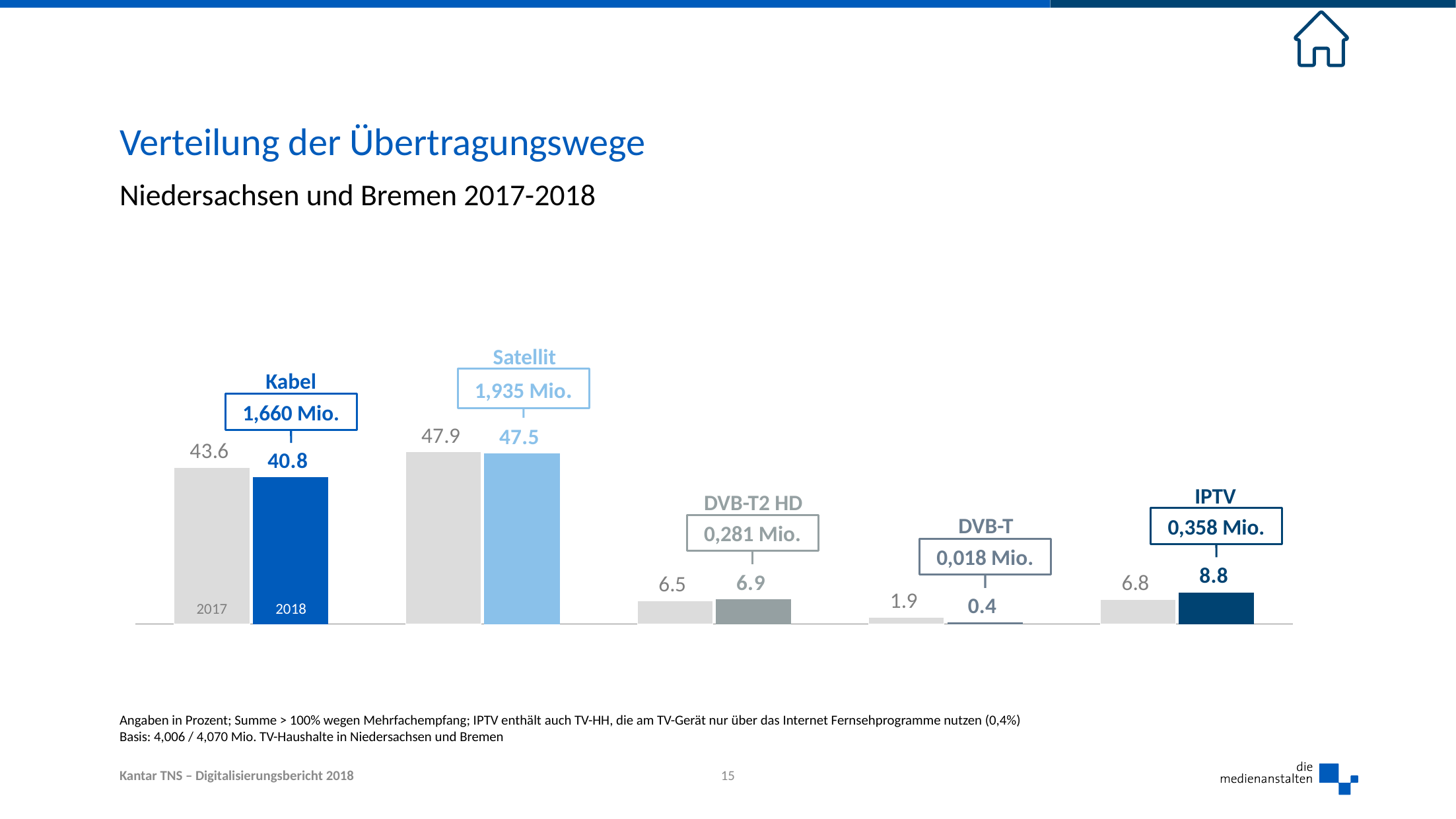
Which category has the lowest 2018 value? DVB-T What is the 2017 value for Satellit? 47.9 What is the 2018 value for Kabel? 40.8 How many transmission categories are shown in the chart? 5 Which is larger for IPTV, the 2017 value or the 2018 value? 2018 What household figure in millions is shown for IPTV? 0,358 Mio. Which category has the highest 2018 value? Satellit What is the difference between the 2017 and 2018 values for Kabel? 2.8 Did the value for DVB-T rise or fall from 2017 to 2018? Fall What is the difference between the 2018 values for IPTV and DVB-T2 HD? 1.9 What kind of chart is shown on the slide? Bar chart What is the 2018 value for DVB-T? 0.4